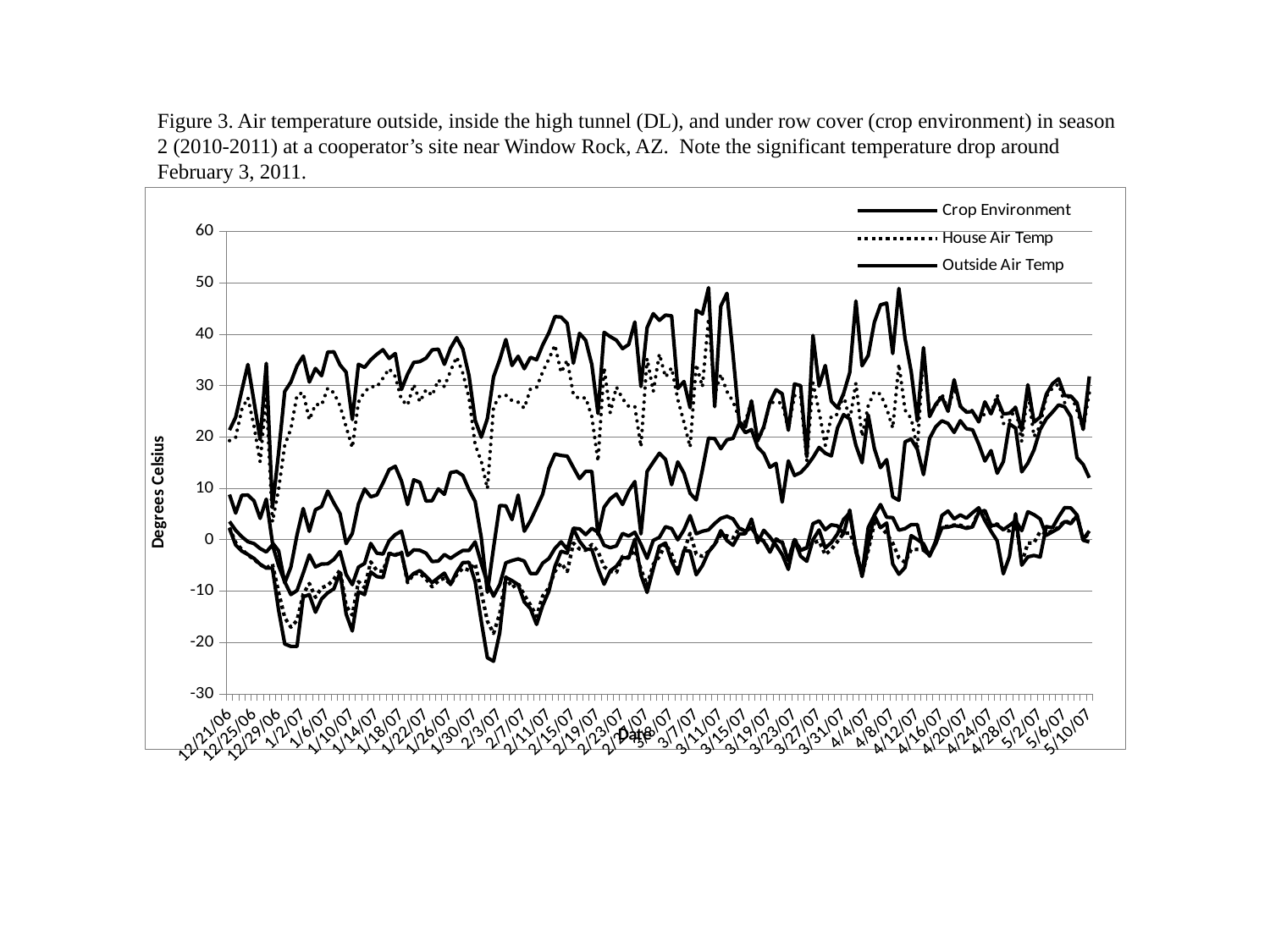
What is the title of the y axis? Degrees Celsius Which series in the legend is drawn with a dotted line? House Air Temp Do the lowest lines on the chart generally rise or fall from 2/3/07 to 5/10/07? rise How many series does the legend list? 3 Is the highest value plotted on the chart greater or less than 40? greater Is the lowest value plotted on the chart, around 2/3/07, greater or less than -20? less What kind of chart is shown on the slide? line chart